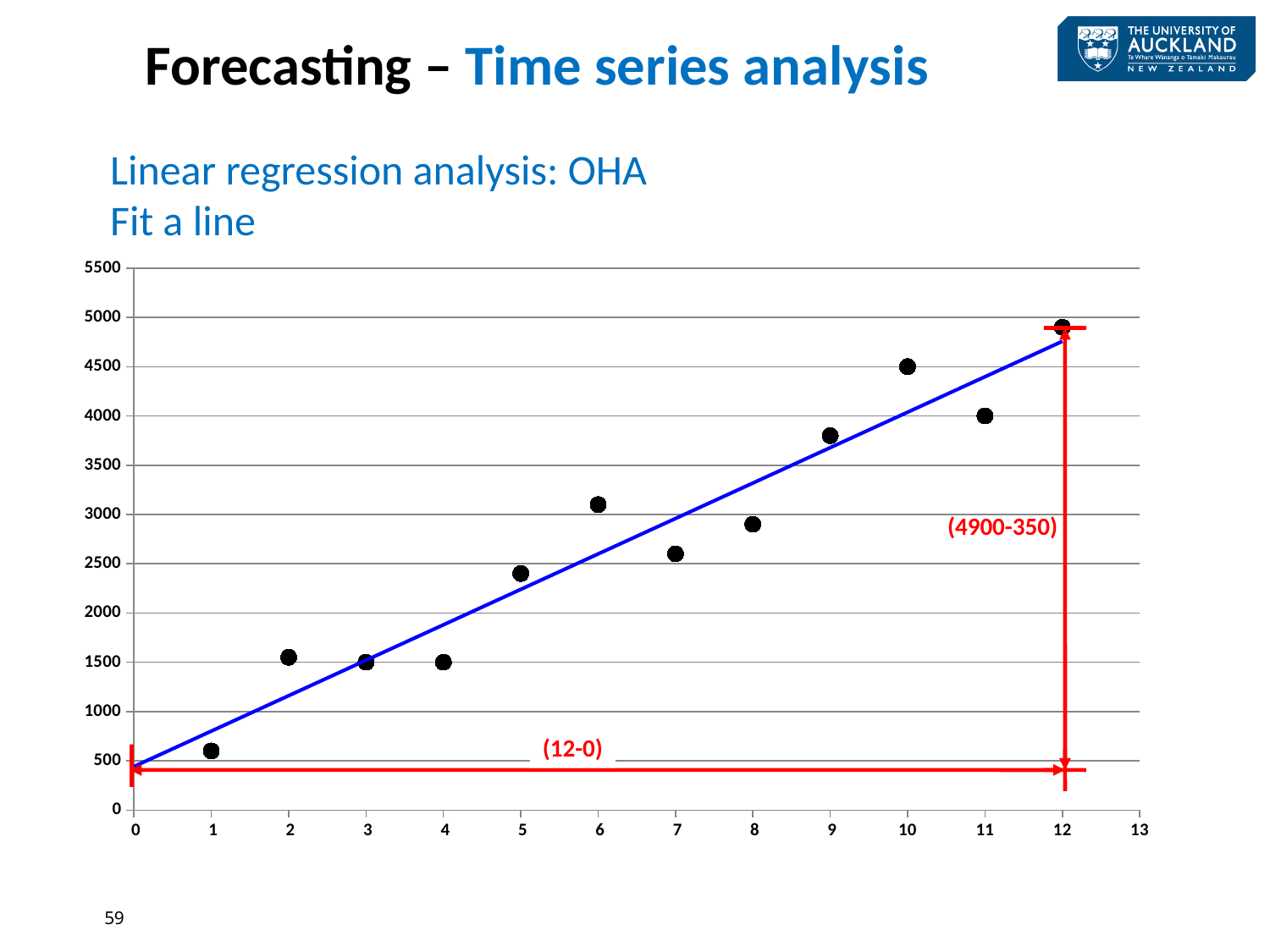
At which x value is the lowest plotted point? 1 Is the plotted value at x = 6 greater or less than 3000? greater What is the plotted value at x = 11? 4000 What kind of chart is shown on the slide? scatter chart How many data points are plotted on the chart? 12 At which x value is the highest plotted point? 12 Which plotted value is larger, the one at x = 6 or the one at x = 7? x = 6 What is the difference between the plotted values at x = 10 and x = 11? 500 What text is written in red next to the vertical arrow on the chart? (4900-350) Do the plotted values generally rise or fall as x increases? rise Is the plotted value at x = 12 greater or less than 4500? greater What is the plotted value at x = 10? 4500